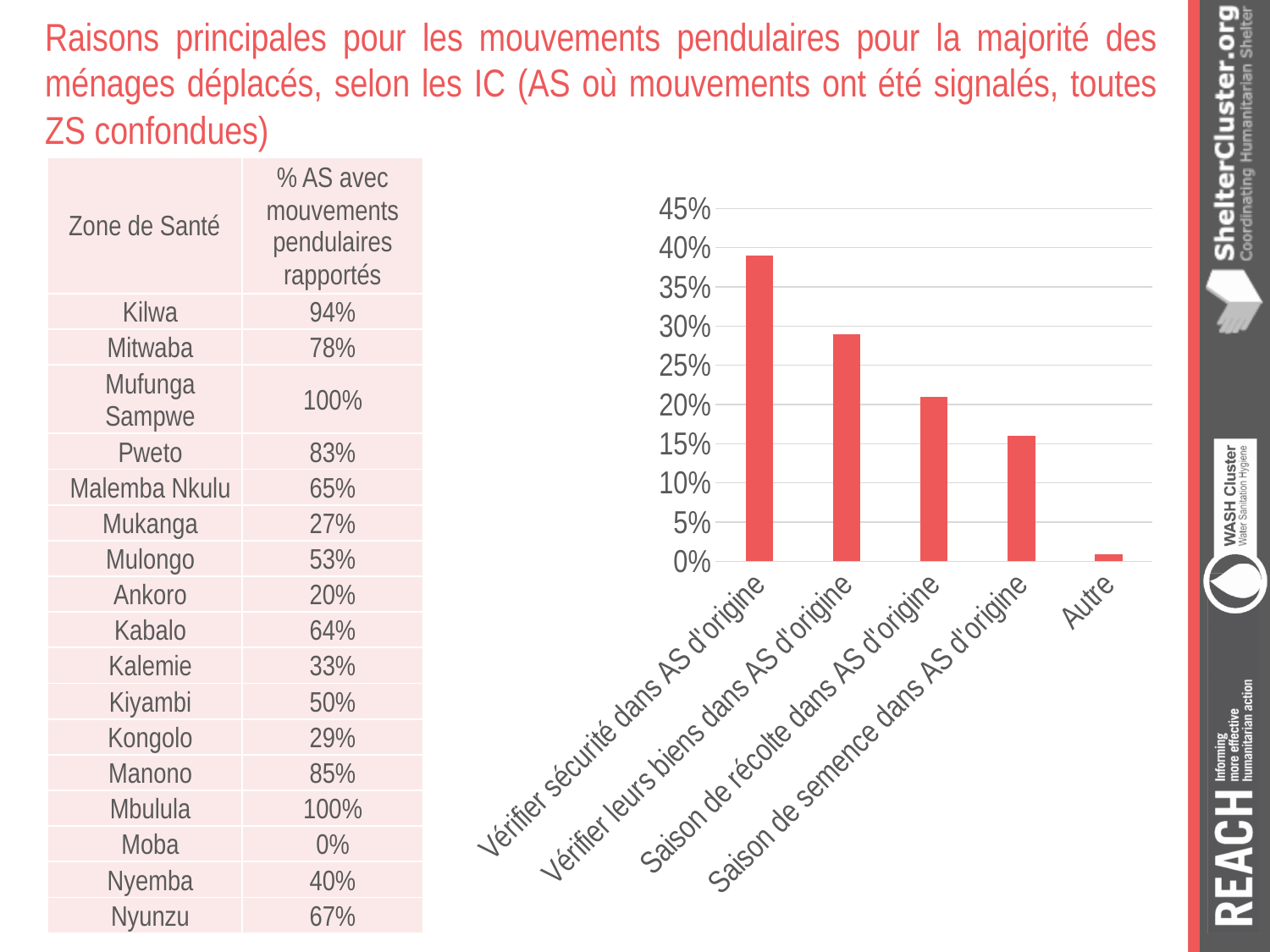
Which category has the lowest bar in the chart? Autre Which is larger: the value for Vérifier leurs biens dans AS d'origine or the value for Saison de semence dans AS d'origine? Vérifier leurs biens dans AS d'origine What is the highest value shown on the chart's vertical axis? 45% How many categories are plotted in the bar chart? 5 Is the value for Saison de semence dans AS d'origine greater or less than 20%? less Do the bar values rise or fall from left to right along the x axis? fall Is the value for Vérifier leurs biens dans AS d'origine greater or less than 25%? greater What kind of chart is shown on the slide? bar chart Is the value for Saison de récolte dans AS d'origine greater or less than 25%? less Which category has the highest bar in the chart? Vérifier sécurité dans AS d'origine